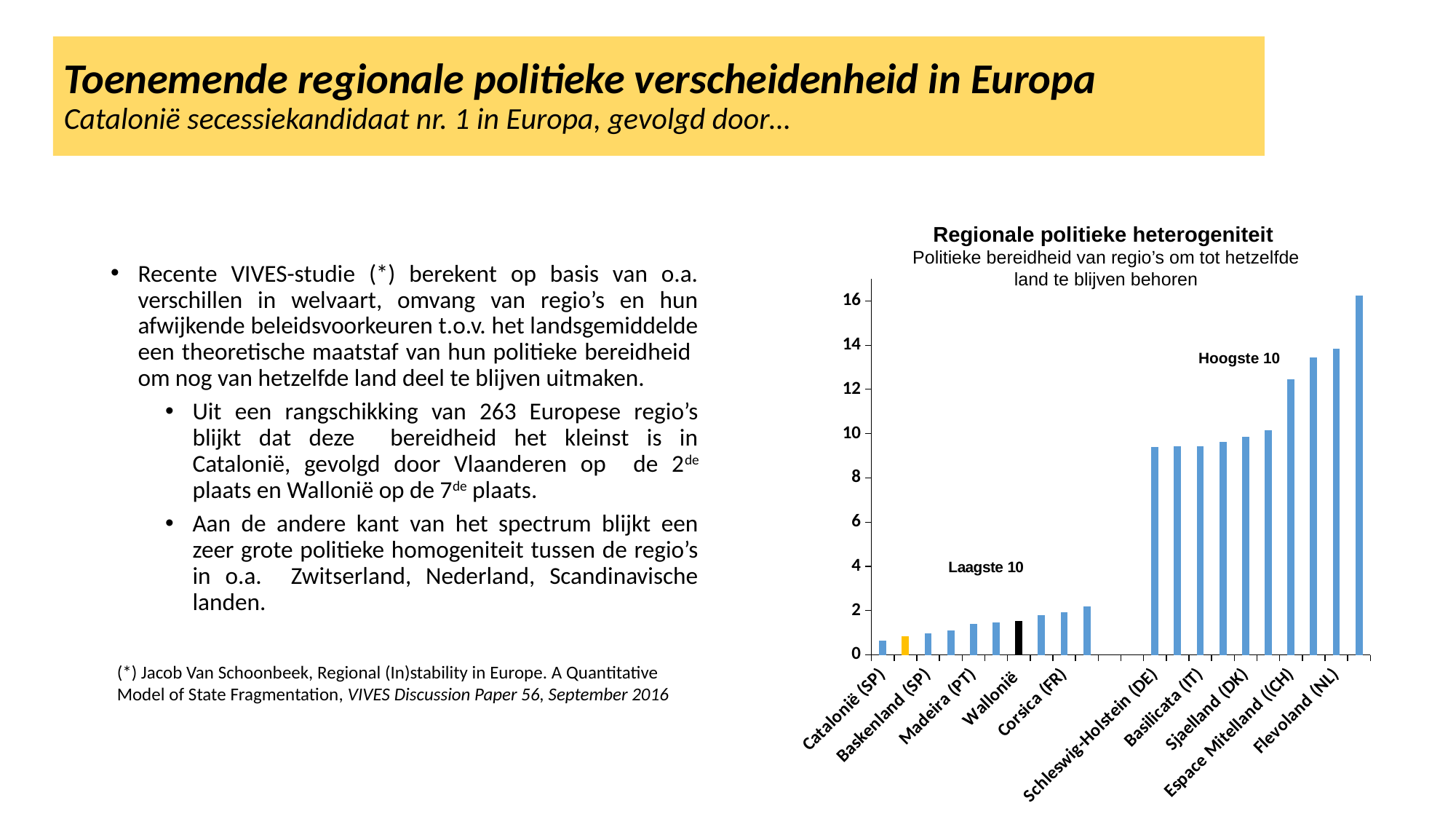
Do the bar values rise or fall from left to right along the x axis? rise How many bars are plotted in the chart? 20 Is the value for Catalonië (SP) greater or less than 2? less Is the value for Schleswig-Holstein (DE) greater or less than 10? less What is the title of the chart? Regionale politieke heterogeniteit What kind of chart is shown on the slide? bar chart Is the value for Madeira (PT) greater or less than 4? less Which labelled region's bar is coloured black? Wallonië Which has the larger value, Sjaelland (DK) or Espace Mitelland (CH)? Espace Mitelland (CH) Which labelled region has the lowest value in the chart? Catalonië (SP) Which has the larger value, Corsica (FR) or Schleswig-Holstein (DE)? Schleswig-Holstein (DE)